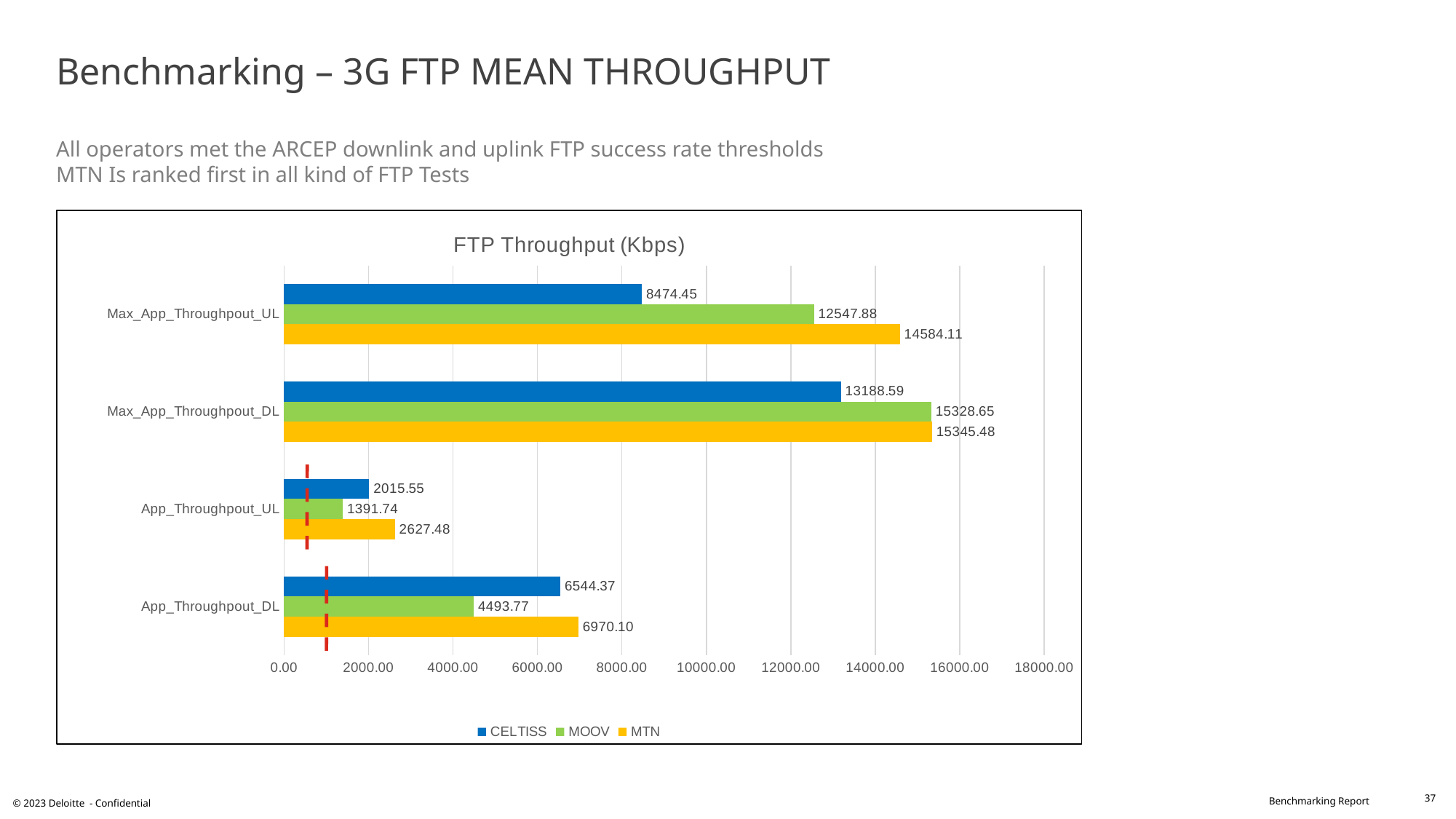
Which operator has the lowest value for App_Throughpout_DL? MOOV How many series does the legend list? 3 Which operator has the highest value for Max_App_Throughpout_UL? MTN What is the CELTISS value for Max_App_Throughpout_DL? 13188.59 What is the MOOV value for App_Throughpout_UL? 1391.74 What is the difference between the MTN and CELTISS values for Max_App_Throughpout_UL? 6109.66 For App_Throughpout_UL, which is larger: the CELTISS value or the MOOV value? CELTISS What kind of chart is shown on the slide? Bar chart What is the difference between the MTN and MOOV values for App_Throughpout_DL? 2476.33 What is the CELTISS value for App_Throughpout_DL? 6544.37 Is the MOOV value for Max_App_Throughpout_UL greater or less than 12000.00? greater What is the MTN value for Max_App_Throughpout_UL? 14584.11